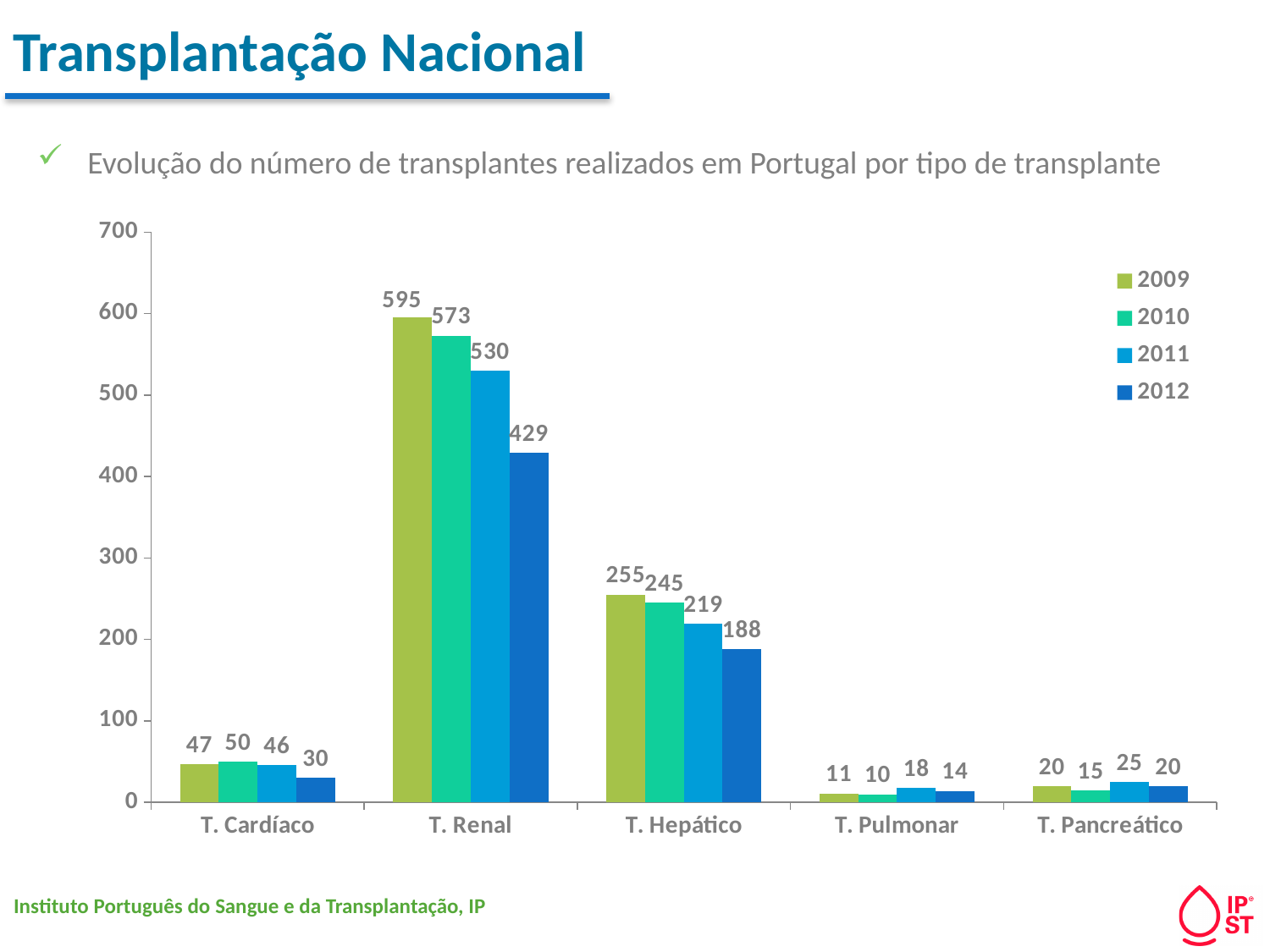
Which transplant type had the lowest number of transplants in 2010? T. Pulmonar Which year is represented by the dark blue bars in the legend? 2012 How many years does the legend list? 4 How many transplant types are shown on the x axis? 5 Which was larger: T. Pancreático transplants in 2011 or T. Cardíaco transplants in 2012? T. Cardíaco transplants in 2012 What was the number of T. Renal transplants in 2012? 429 Did the number of T. Hepático transplants rise or fall from 2009 to 2012? Fall What was the number of T. Hepático transplants in 2010? 245 What kind of chart is shown on the slide? Bar chart What is the difference between the number of T. Renal transplants in 2009 and in 2012? 166 Which transplant type had the highest number of transplants in 2011? T. Renal What was the number of T. Cardíaco transplants in 2009? 47